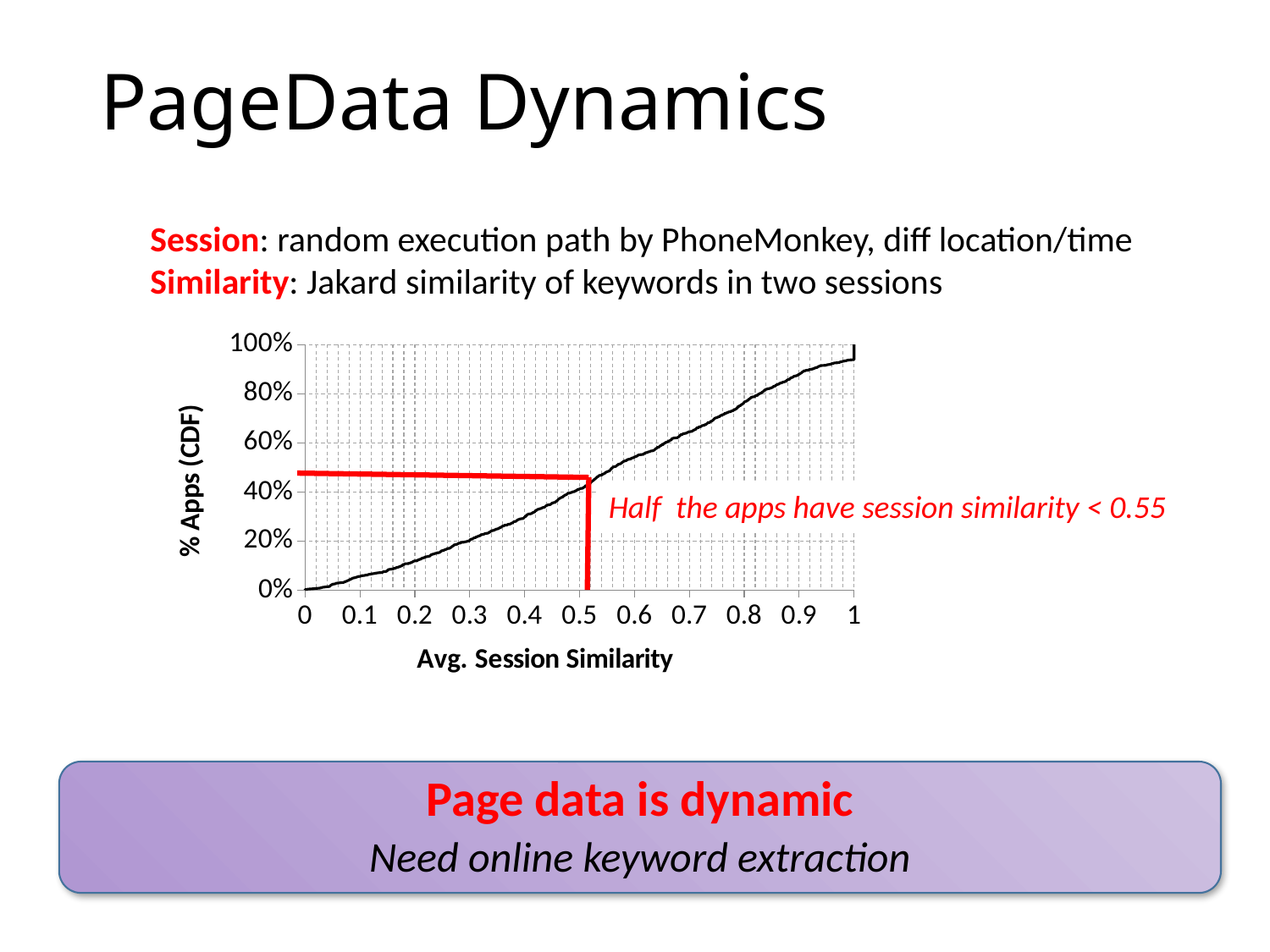
Is the % Apps (CDF) value at an Avg. Session Similarity of 0.7 greater or less than 40%? greater What kind of chart is shown on the slide? line chart Is the % Apps (CDF) value at an Avg. Session Similarity of 0.6 greater or less than 40%? greater Is the % Apps (CDF) value at an Avg. Session Similarity of 0.2 greater or less than 20%? less Does the plotted line rise or fall as Avg. Session Similarity increases from 0 to 1? rise Which is larger, the % Apps (CDF) value at Avg. Session Similarity 0.3 or at 0.8? 0.8 What is the label of the x axis of the chart? Avg. Session Similarity How many tick labels are shown on the x axis of the chart? 11 What is the label of the y axis of the chart? % Apps (CDF)